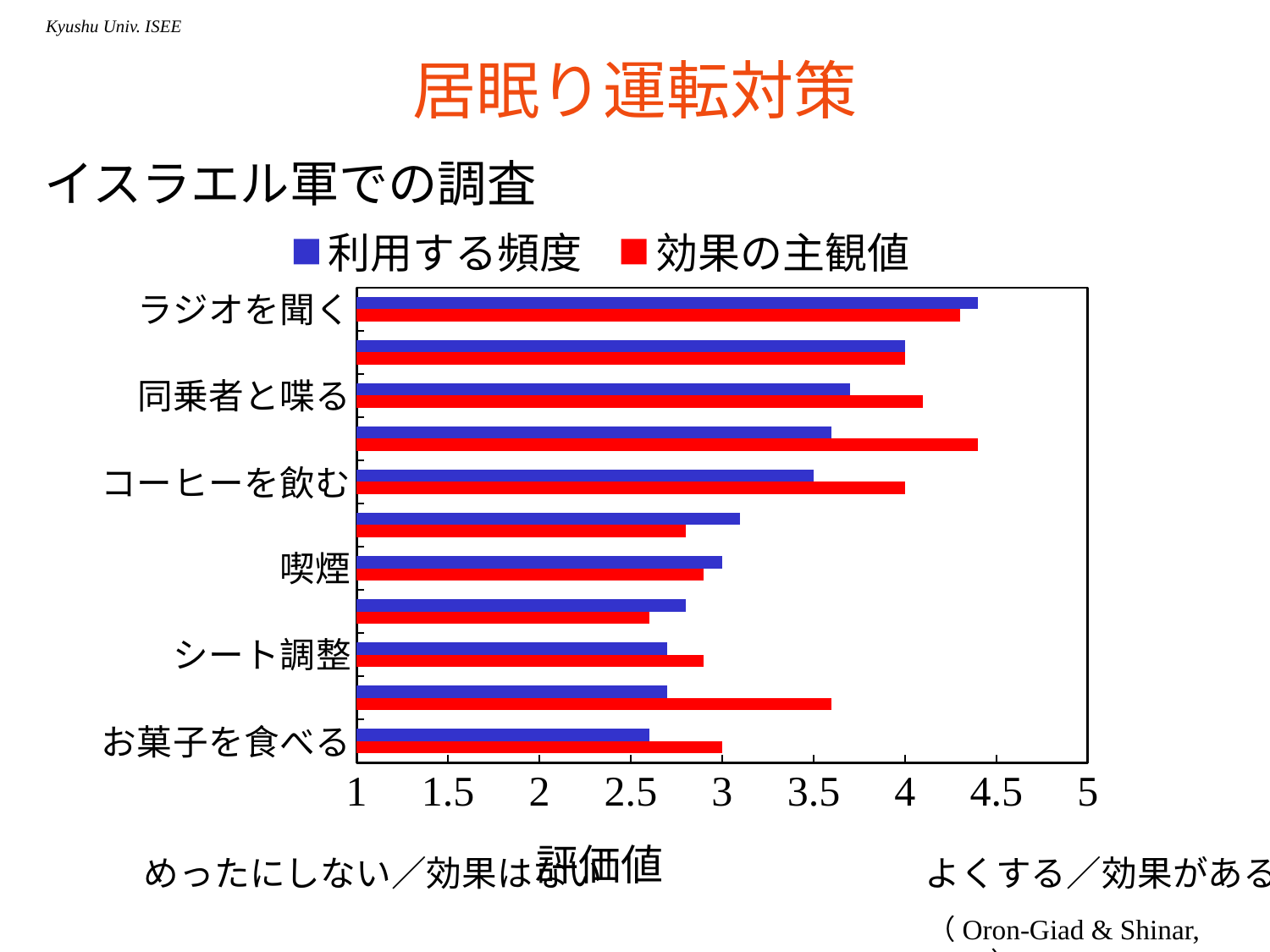
For お菓子を食べる, which is larger: 利用する頻度 or 効果の主観値? 効果の主観値 Which has the larger 利用する頻度 value: ラジオを聞く or お菓子を食べる? ラジオを聞く Is the 利用する頻度 value for シート調整 greater or less than 3? less Is the 利用する頻度 value for ラジオを聞く greater or less than 4? greater What is the label of the horizontal axis of the chart? 評価値 What kind of chart is shown on the slide? bar chart Among the labelled categories, which has the highest 利用する頻度 value? ラジオを聞く Is the 利用する頻度 value for お菓子を食べる greater or less than 3? less Which colour represents 利用する頻度 in the chart? blue For コーヒーを飲む, which is larger: 利用する頻度 or 効果の主観値? 効果の主観値 How many series does the chart legend list? 2